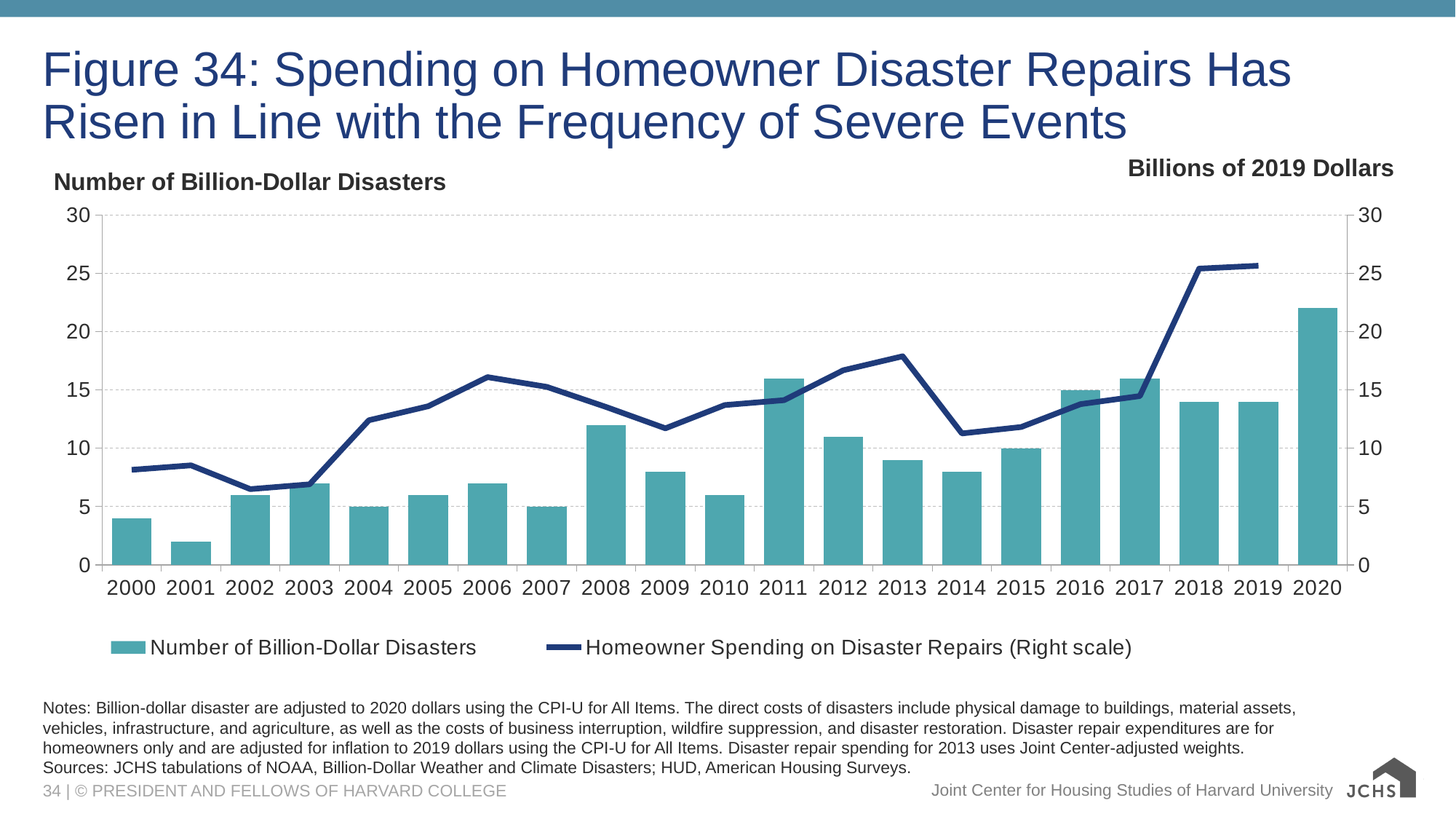
Which year has the highest number of billion-dollar disasters? 2020 Is the homeowner spending on disaster repairs in 2014 greater or less than 10 billion 2019 dollars? greater Overall, does the number of billion-dollar disasters rise or fall from 2000 to 2020? rise Which year had more billion-dollar disasters, 2011 or 2012? 2011 What is the number of billion-dollar disasters in 2004? 5 Which year has the lowest number of billion-dollar disasters? 2001 How many series does the legend list? 2 What kind of chart is shown on the slide? A bar chart with a line series Is the homeowner spending on disaster repairs in 2013 greater or less than 20 billion 2019 dollars? less What is the number of billion-dollar disasters in 2016? 15 Is the number of billion-dollar disasters in 2020 greater or less than 20? greater How many years are shown on the x axis? 21